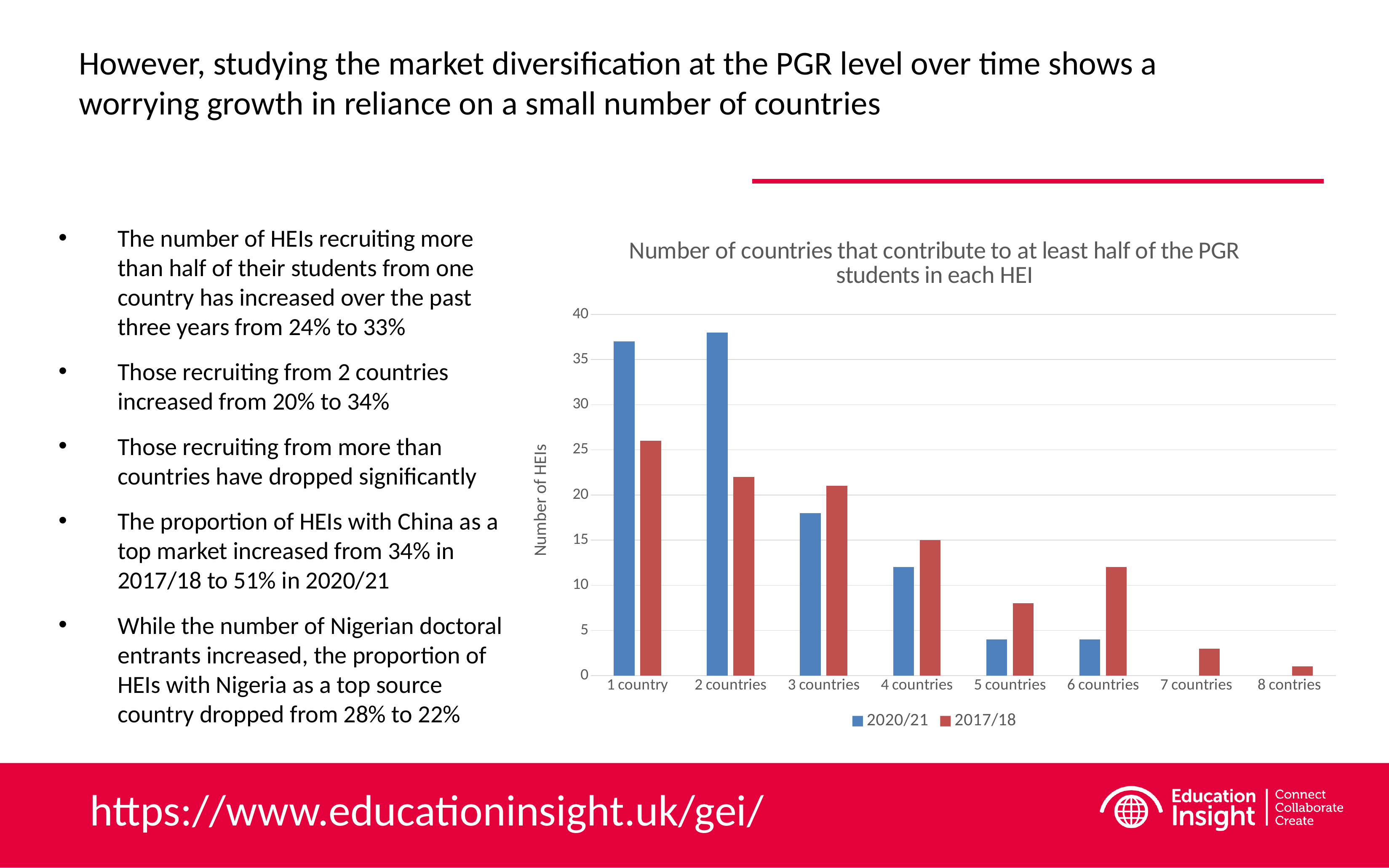
How many categories are shown on the x axis? 8 Which category has the highest value for the 2017/18 series? 1 country Is the 2020/21 value for 5 countries greater or less than 5? less Is the 2020/21 value for 1 country greater or less than 35? greater Is the 2017/18 value for 2 countries greater or less than 20? greater What is the label on the y axis of the chart? Number of HEIs For 1 country, which series has the larger value, 2020/21 or 2017/18? 2020/21 Do the 2017/18 values generally rise or fall from 1 country to 8 countries? fall What kind of chart is shown on the slide? bar chart How many series does the legend list? 2 Which category has the lowest non-zero value for the 2017/18 series? 8 contries For 6 countries, which series has the larger value, 2020/21 or 2017/18? 2017/18